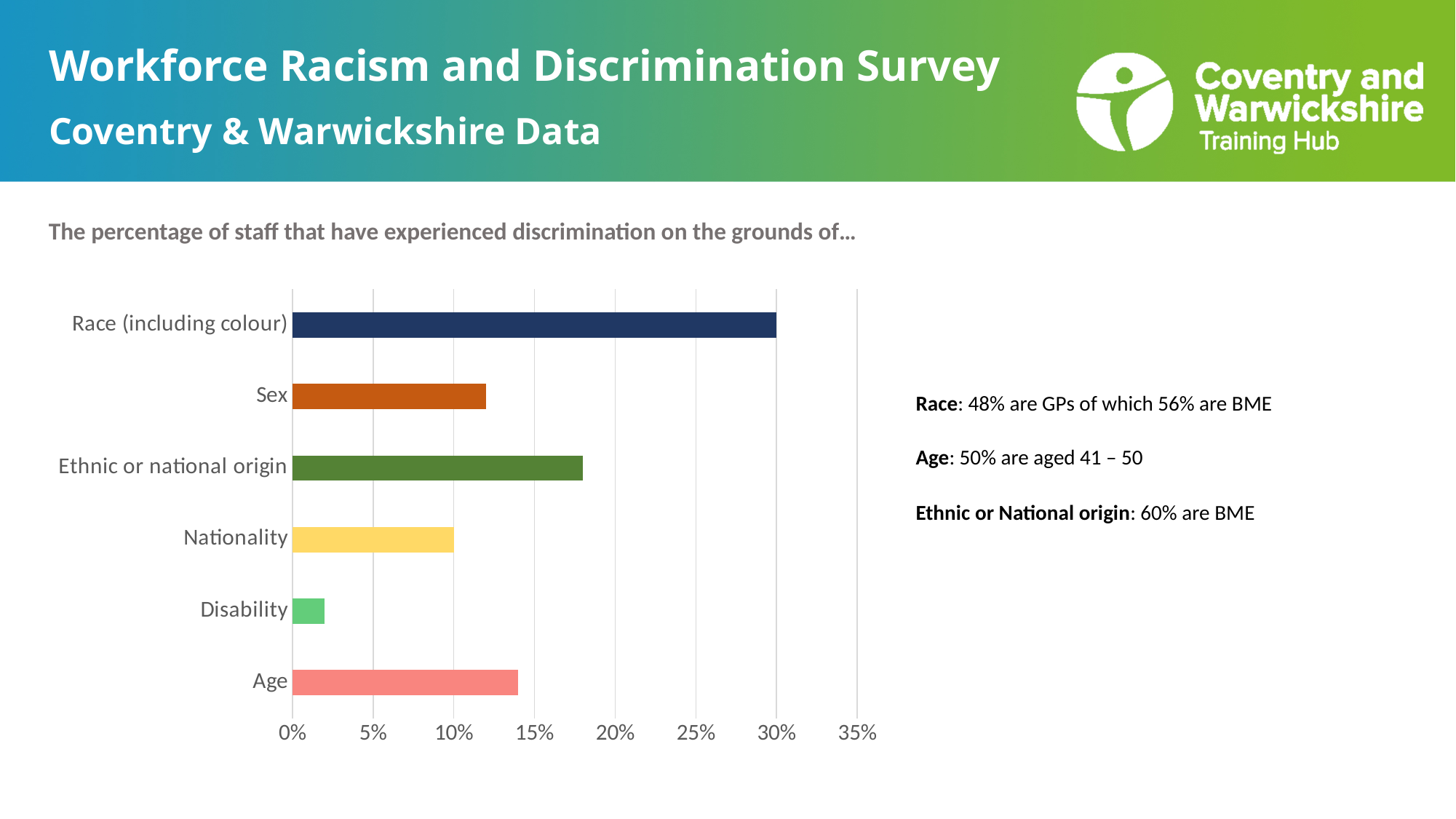
What is the maximum value shown on the horizontal axis of the chart? 35% Is the value for Disability greater or less than 5%? less How many categories are plotted in the chart? 6 Which category has the highest percentage of staff experiencing discrimination? Race (including colour) Is the value for Age greater or less than 15%? less Which category has the lowest percentage of staff experiencing discrimination? Disability Which is larger, the value for Ethnic or national origin or the value for Sex? Ethnic or national origin What kind of chart is shown on the slide? Bar chart Is the value for Ethnic or national origin greater or less than 15%? greater What percentage of staff experienced discrimination on the grounds of Nationality? 10% What percentage of staff experienced discrimination on the grounds of Race (including colour)? 30%